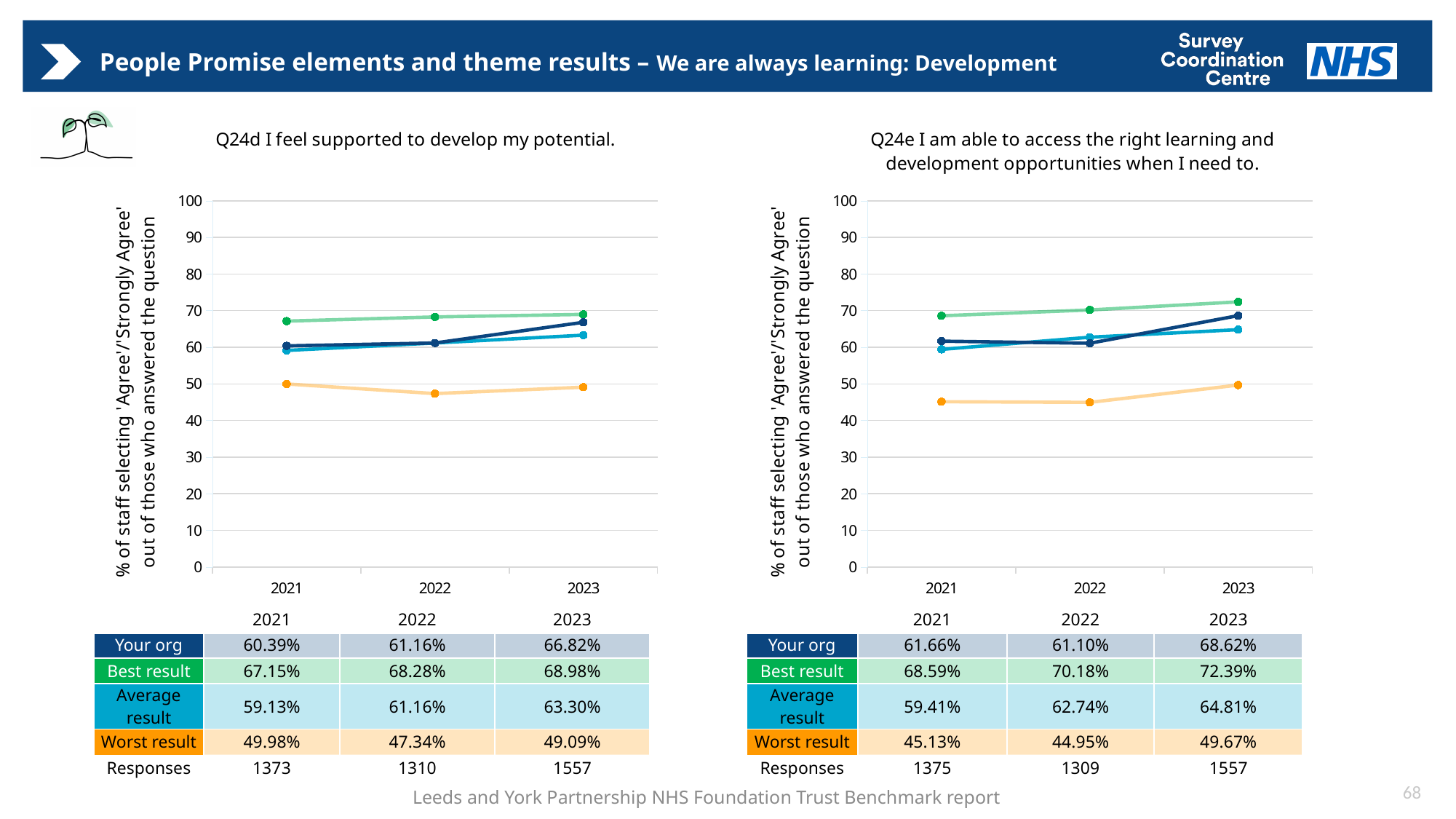
On the Q24e chart, what is the difference between the 'Your org' values in 2023 and 2022? 7.52% On the Q24e chart, in which year was the 'Best result' highest? 2023 On the Q24d chart, what was the 'Worst result' value in 2022? 47.34% On the Q24d chart, what is the difference between the 'Best result' and 'Your org' values in 2023? 2.16% On the Q24d chart, is the 'Worst result' value in 2021 greater or less than 60? less What kind of chart is used for Q24d? Line chart On the Q24e chart, does the 'Best result' line rise or fall from 2021 to 2023? Rise On the Q24e chart, what was the 'Average result' value in 2021? 59.41% On the Q24e chart, what was the 'Best result' value in 2022? 70.18% On the Q24d chart, in which year was the 'Worst result' lowest? 2022 On the Q24e chart, which is larger in 2021: 'Your org' or 'Average result'? Your org On the Q24d chart, what was the 'Your org' value in 2023? 66.82%